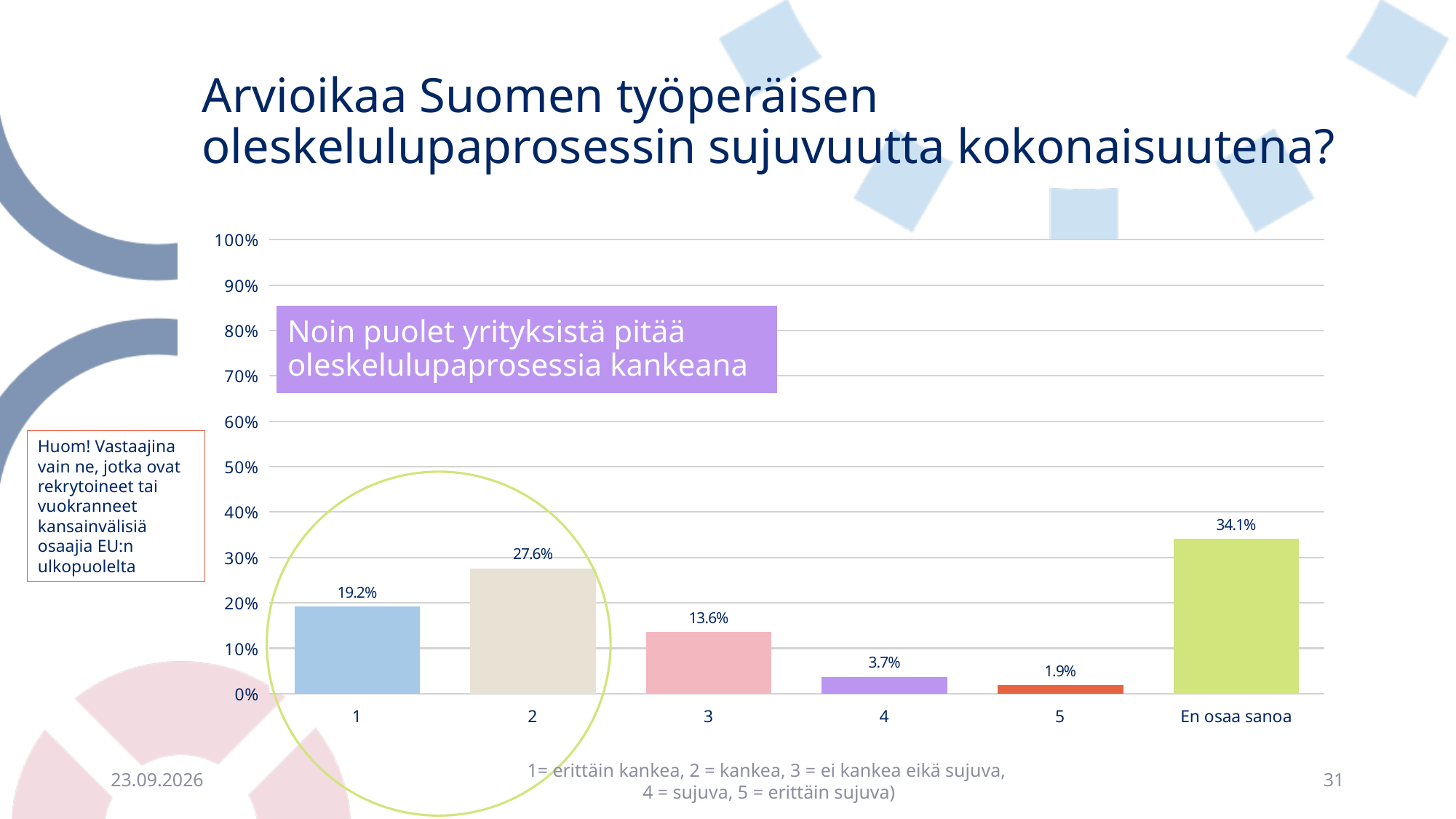
What is the difference between the values for category 2 and category 1? 8.4% What is the combined value of categories 1 and 2? 46.8% What is the value for category 2? 27.6% How many categories are shown on the x axis? 6 What kind of chart is shown on the slide? bar chart What is the value for "En osaa sanoa"? 34.1% Which category has the highest value? En osaa sanoa Which is larger, the value for category 3 or the value for category 4? 3 What is the value for category 5? 1.9% Is the value for category 2 greater or less than 30%? less What is the value for category 1? 19.2% Which category has the lowest value? 5